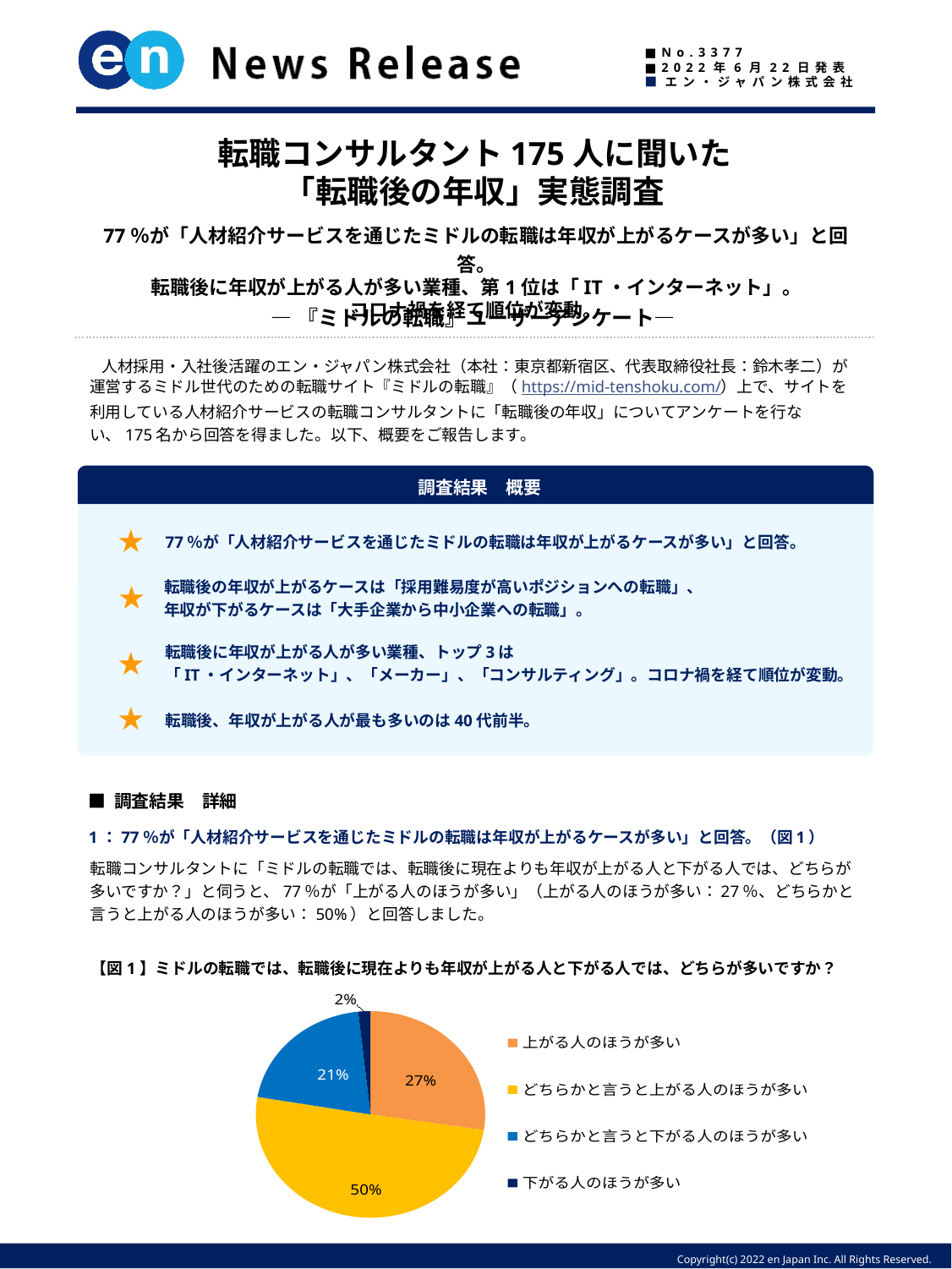
What is the difference in percentage points between 「どちらかと言うと上がる人のほうが多い」 and 「上がる人のほうが多い」 in the pie chart? 23 Which category has the smallest slice in the pie chart? 下がる人のほうが多い In the pie chart, what share is labelled for 「下がる人のほうが多い」? 2% What kind of chart is shown in 【図1】? pie chart Which is larger in the pie chart: 「上がる人のほうが多い」 or 「どちらかと言うと下がる人のほうが多い」? 上がる人のほうが多い In the pie chart, what share is labelled for 「上がる人のほうが多い」? 27% In the pie chart, what share is labelled for 「どちらかと言うと下がる人のほうが多い」? 21% What colour is the slice for 「どちらかと言うと上がる人のほうが多い」 in the pie chart? yellow In the pie chart, what share is labelled for 「どちらかと言うと上がる人のほうが多い」? 50% What is the combined share of 「上がる人のほうが多い」 and 「どちらかと言うと上がる人のほうが多い」 in the pie chart? 77% How many categories does the pie chart's legend list? 4 Which category has the largest slice in the pie chart? どちらかと言うと上がる人のほうが多い